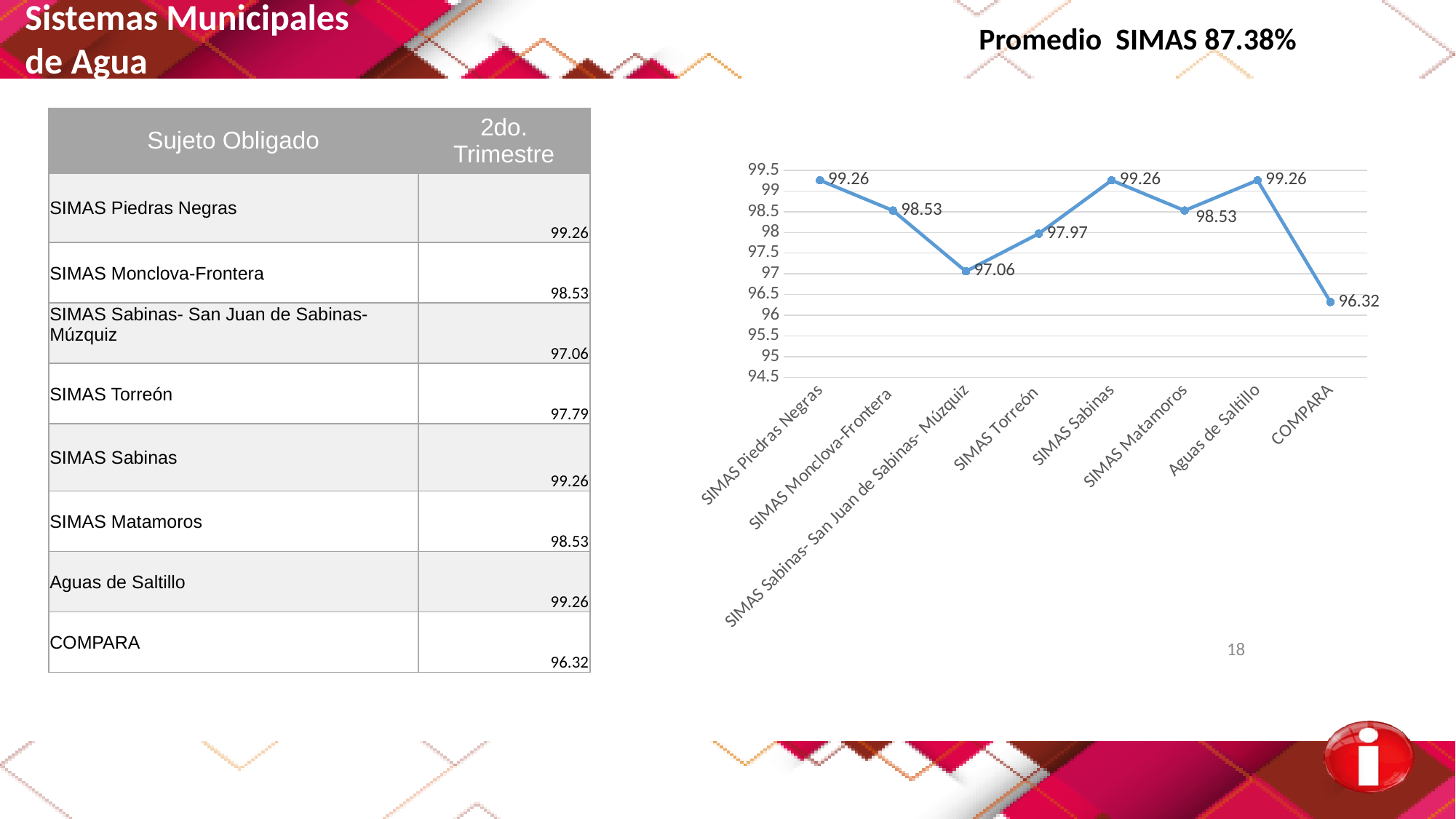
What kind of chart is shown on the slide? line chart What is the value plotted for SIMAS Sabinas- San Juan de Sabinas- Múzquiz? 97.06 How many categories are plotted on the chart? 8 What is the difference between the values for SIMAS Monclova-Frontera and SIMAS Sabinas- San Juan de Sabinas- Múzquiz? 1.47 Does the line rise or fall from Aguas de Saltillo to COMPARA? fall Which category has the lowest value on the chart? COMPARA Which has a higher value, SIMAS Matamoros or COMPARA? SIMAS Matamoros What is the difference between the values for SIMAS Piedras Negras and COMPARA? 2.94 What is the value plotted for SIMAS Piedras Negras? 99.26 Is the value for Aguas de Saltillo greater or less than 99? greater What is the value plotted for COMPARA? 96.32 What is the value plotted for SIMAS Matamoros? 98.53